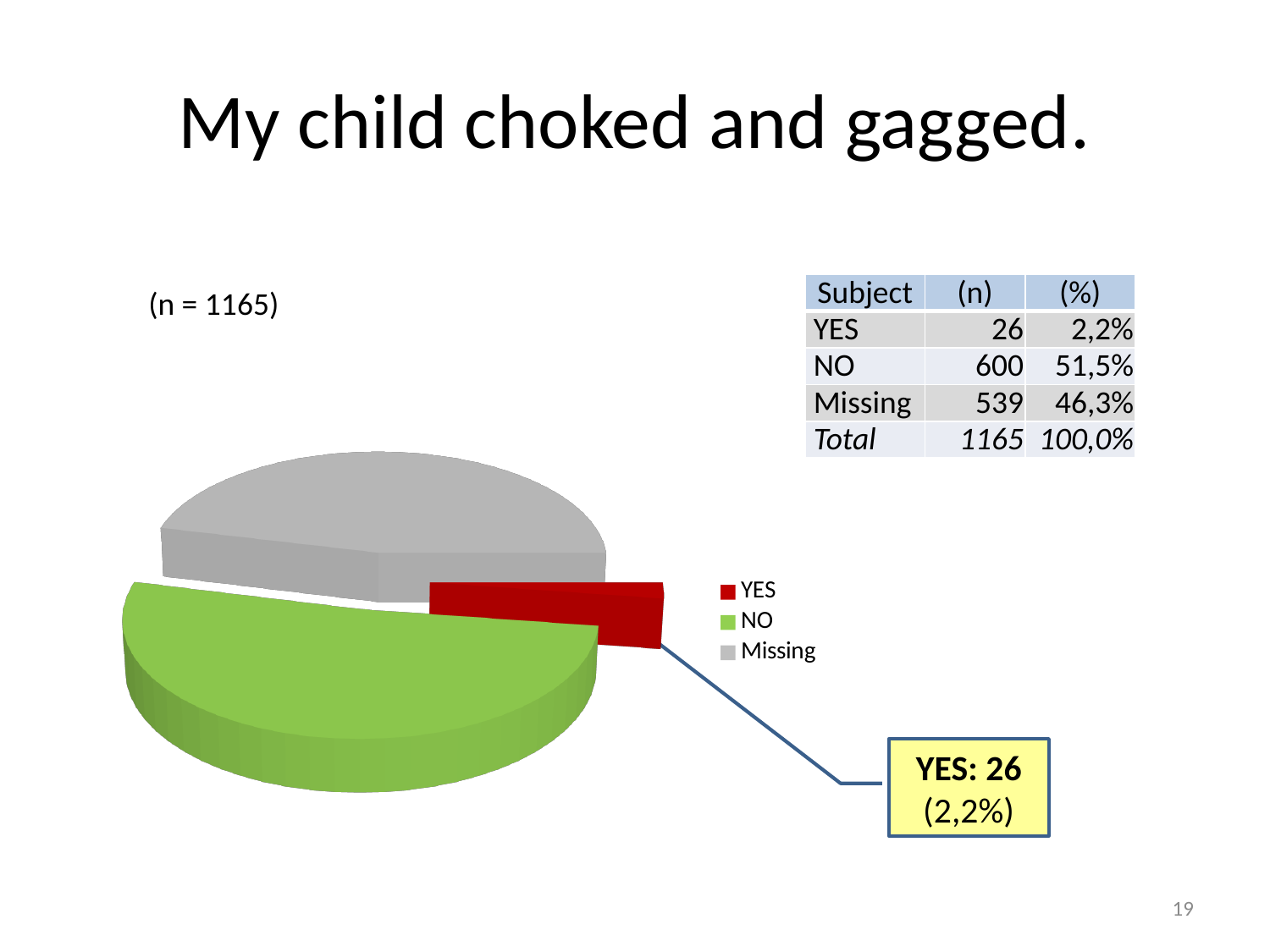
What percentage share does the NO slice have? 51,5% How many categories does the pie chart have? 3 How many entries does the legend list? 3 What is the count (n) for the NO category? 600 What percentage share does the YES slice have? 2,2% Which category has the largest slice? NO Which colour represents the YES category in the pie chart? red What percentage share does the Missing slice have? 46,3% What kind of chart is shown on the slide? pie chart Which category has the smallest slice? YES What is the count (n) for the YES category? 26 What is the difference in count between NO and Missing? 61